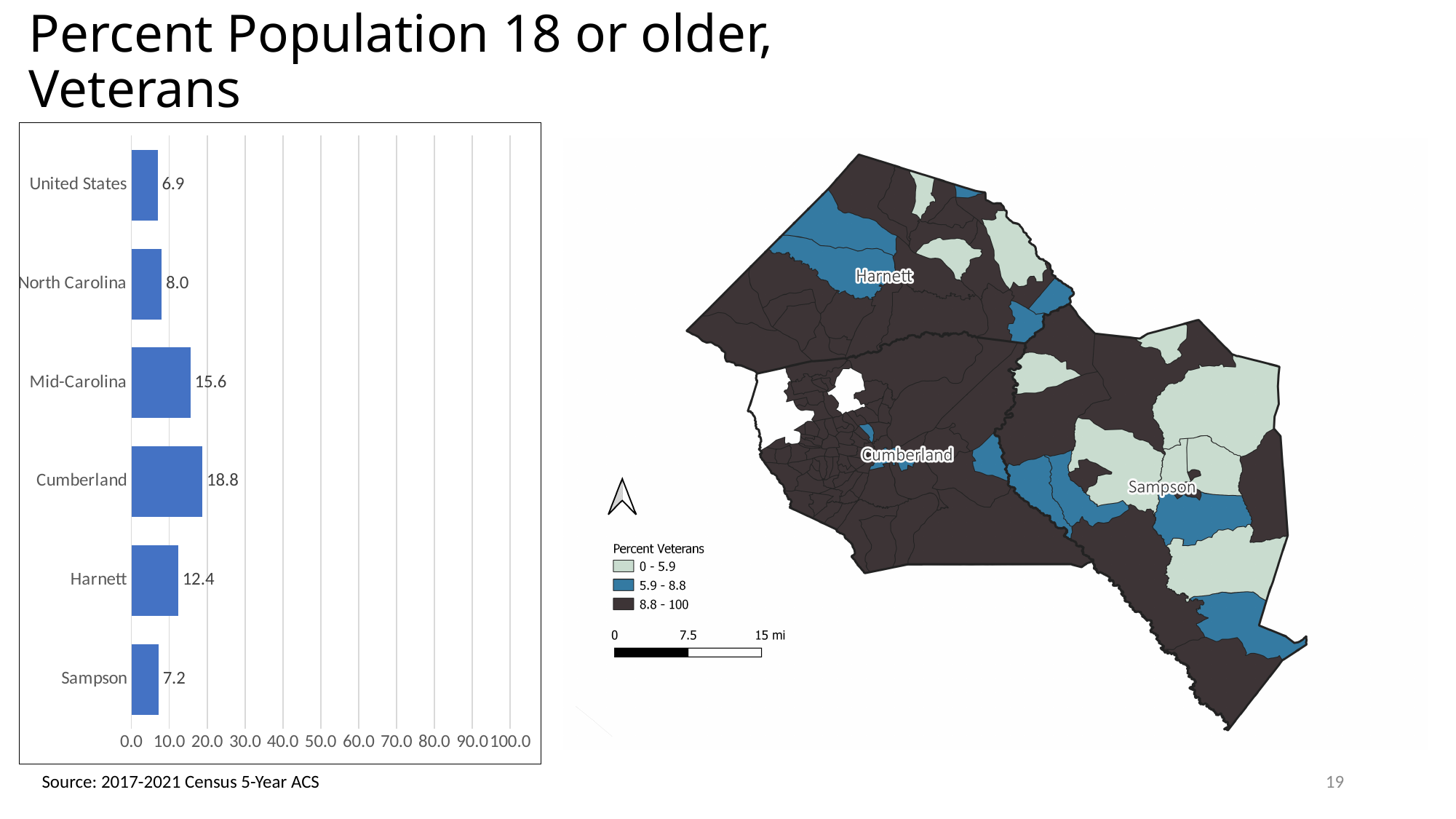
Which is larger in the bar chart, the value for Sampson or the value for North Carolina? North Carolina How many ranges does the map legend for Percent Veterans list? 3 What is the value for Cumberland in the bar chart? 18.8 Which category has the lowest value in the bar chart? United States What kind of chart is shown on the left of the slide? bar chart What is the value for North Carolina in the bar chart? 8.0 What is the difference between the values for Mid-Carolina and Sampson in the bar chart? 8.4 Is the value for Mid-Carolina in the bar chart greater or less than 10.0? greater What is the difference between the values for Cumberland and Harnett in the bar chart? 6.4 How many categories are shown in the bar chart? 6 Which category has the highest value in the bar chart? Cumberland What is the value for Harnett in the bar chart? 12.4